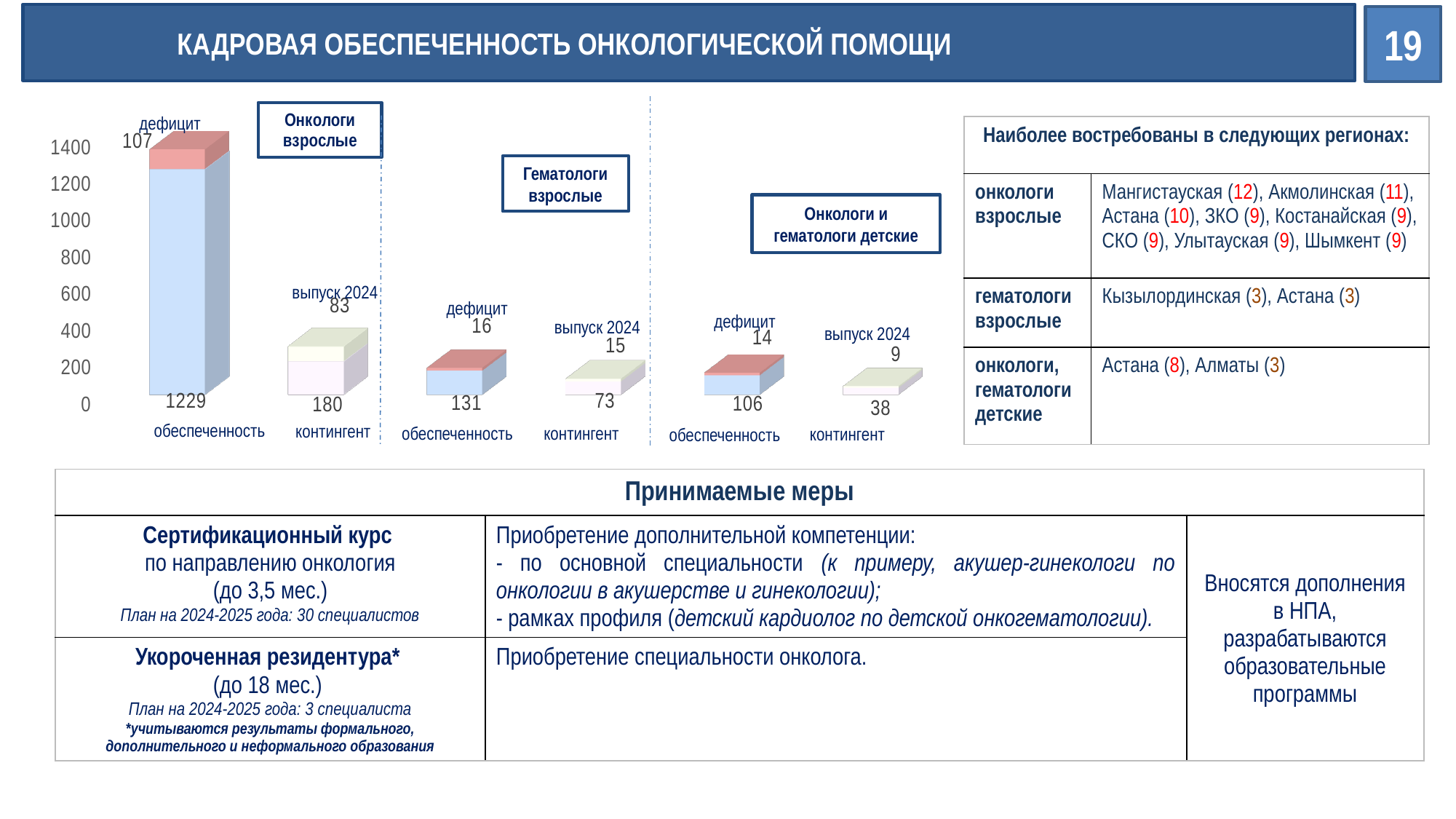
What is the обеспеченность value for Онкологи взрослые? 1229 Which is larger: the дефицит for Онкологи взрослые or the выпуск 2024 for Онкологи взрослые? дефицит for Онкологи взрослые What is the контингент value for Онкологи взрослые? 180 What is the выпуск 2024 value for Онкологи и гематологи детские? 9 What is the total height of the обеспеченность bar for Онкологи взрослые (обеспеченность plus дефицит)? 1336 Which group has the lowest контингент value? Онкологи и гематологи детские What is the difference between the обеспеченность values for Гематологи взрослые and Онкологи и гематологи детские? 25 How many bars are plotted in the chart? 6 Which group has the highest обеспеченность value? Онкологи взрослые What kind of chart is shown on the slide? Stacked bar chart What is the дефицит value for Гематологи взрослые? 16 What is the total height of the контингент bar for Гематологи взрослые (контингент plus выпуск 2024)? 88